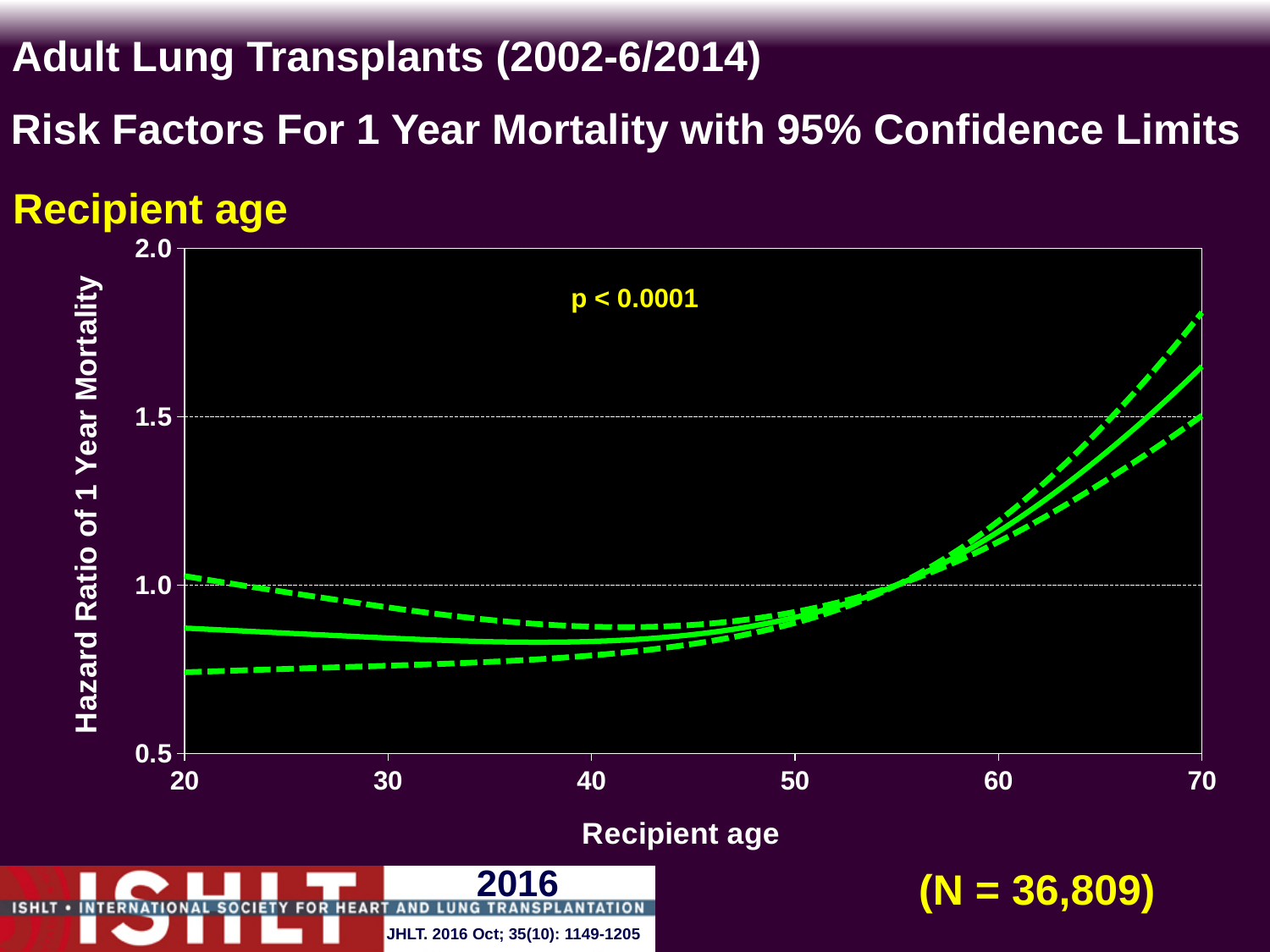
Is the hazard ratio (solid line) at recipient age 40 greater or less than 1.0? less How many lines are plotted on the chart? 3 Is the hazard ratio (solid line) at recipient age 60 greater or less than 1.0? greater Is the upper confidence limit (upper dashed line) at recipient age 70 greater or less than 1.5? greater Is the hazard ratio (solid line) at recipient age 70 higher or lower than at recipient age 20? higher What is the label of the y axis? Hazard Ratio of 1 Year Mortality Does the hazard ratio (solid line) rise or fall between recipient age 50 and 70? rise What kind of chart is shown on the slide? line chart What is the label of the x axis? Recipient age How many tick labels are shown on the x axis? 6